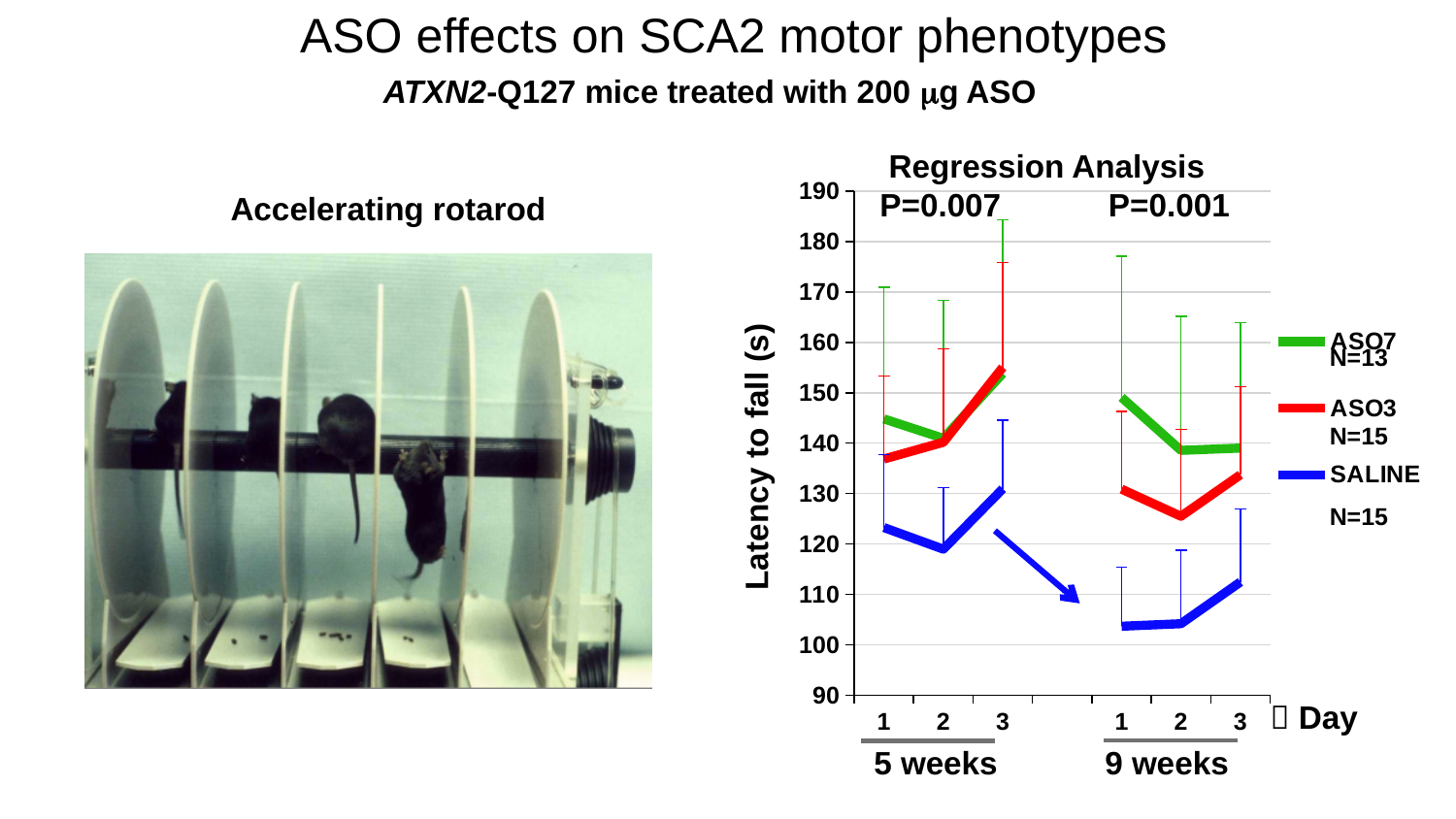
How many day points are plotted for each series within the 5 weeks period? 3 Does the SALINE latency to fall rise or fall from day 1 to day 3 at 9 weeks? rise Is the ASO7 value on day 1 at 5 weeks greater or less than 140? greater Which series has the lowest latency to fall on day 1 at 9 weeks? SALINE What is the y-axis label of the Regression Analysis chart? Latency to fall (s) Is the ASO3 value on day 3 at 5 weeks greater or less than 150? greater Which series is plotted in blue on the Regression Analysis chart? SALINE Is the SALINE value on day 1 at 9 weeks greater or less than 110? less On day 1 at 9 weeks, which is larger: the ASO7 value or the SALINE value? ASO7 What kind of chart is shown under the title "Regression Analysis"? line chart How many series does the legend of the Regression Analysis chart list? 3